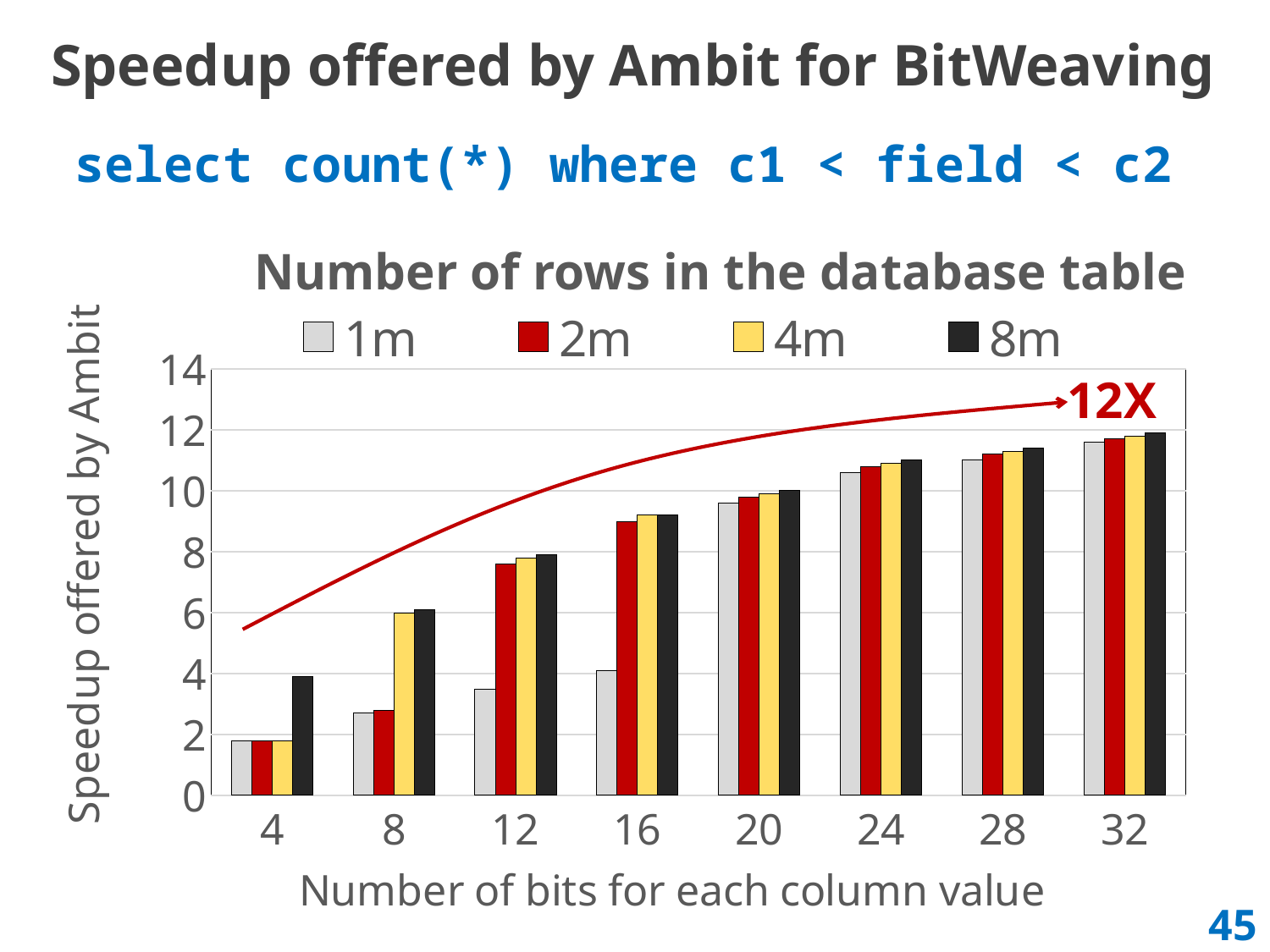
How many series does the legend list? 4 Is the value for 8m at 32 bits greater or less than 10? greater Do the speedup values rise or fall as the number of bits increases? rise At 4 bits, which is larger: the 1m bar or the 8m bar? 8m What kind of chart is shown on the slide? bar chart How many categories are shown on the x axis? 8 Is the value for 2m at 12 bits greater or less than 8? less Which series has the highest bar at 4 bits? 8m What speedup value is called out by the red annotation on the chart? 12X Is the value for 1m at 20 bits greater or less than 8? greater Which series has the lowest bar at 12 bits? 1m